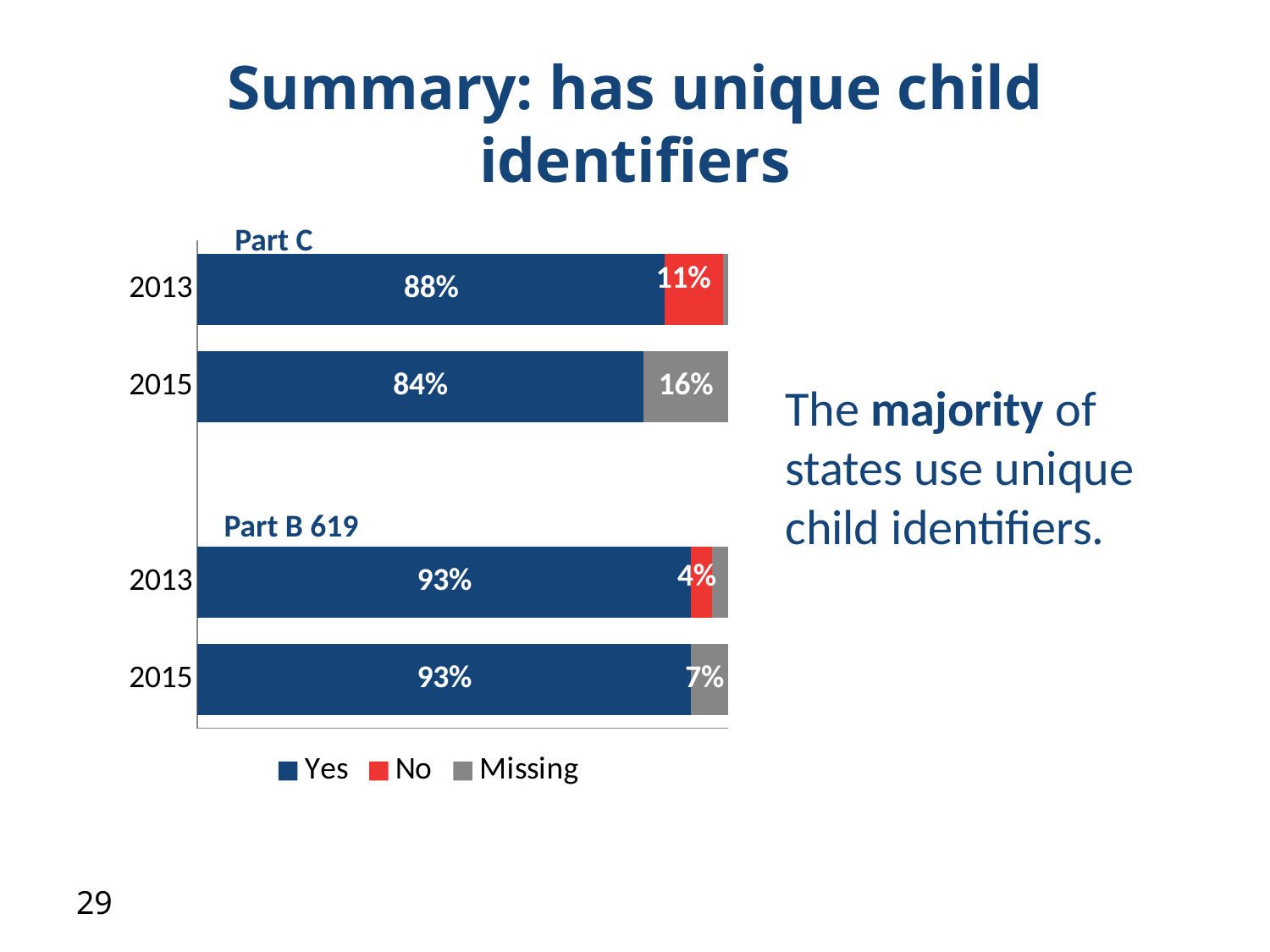
How many series does the legend list? 3 What is the No percentage for Part B 619 in 2013? 4% Which has a larger Yes share in 2015, Part C or Part B 619? Part B 619 Which colour represents the No responses in the chart? Red What percentage of states answered Yes for Part C in 2013? 88% What is the Missing percentage for Part C in 2015? 16% What is the No percentage for Part C in 2013? 11% What percentage of states answered Yes for Part B 619 in 2013? 93% What kind of chart is shown on the slide? Stacked bar chart What percentage of states answered Yes for Part C in 2015? 84% What is the Missing percentage for Part B 619 in 2015? 7% By how many percentage points did the Yes share for Part C change from 2013 to 2015? 4 percentage points (decreased from 88% to 84%)